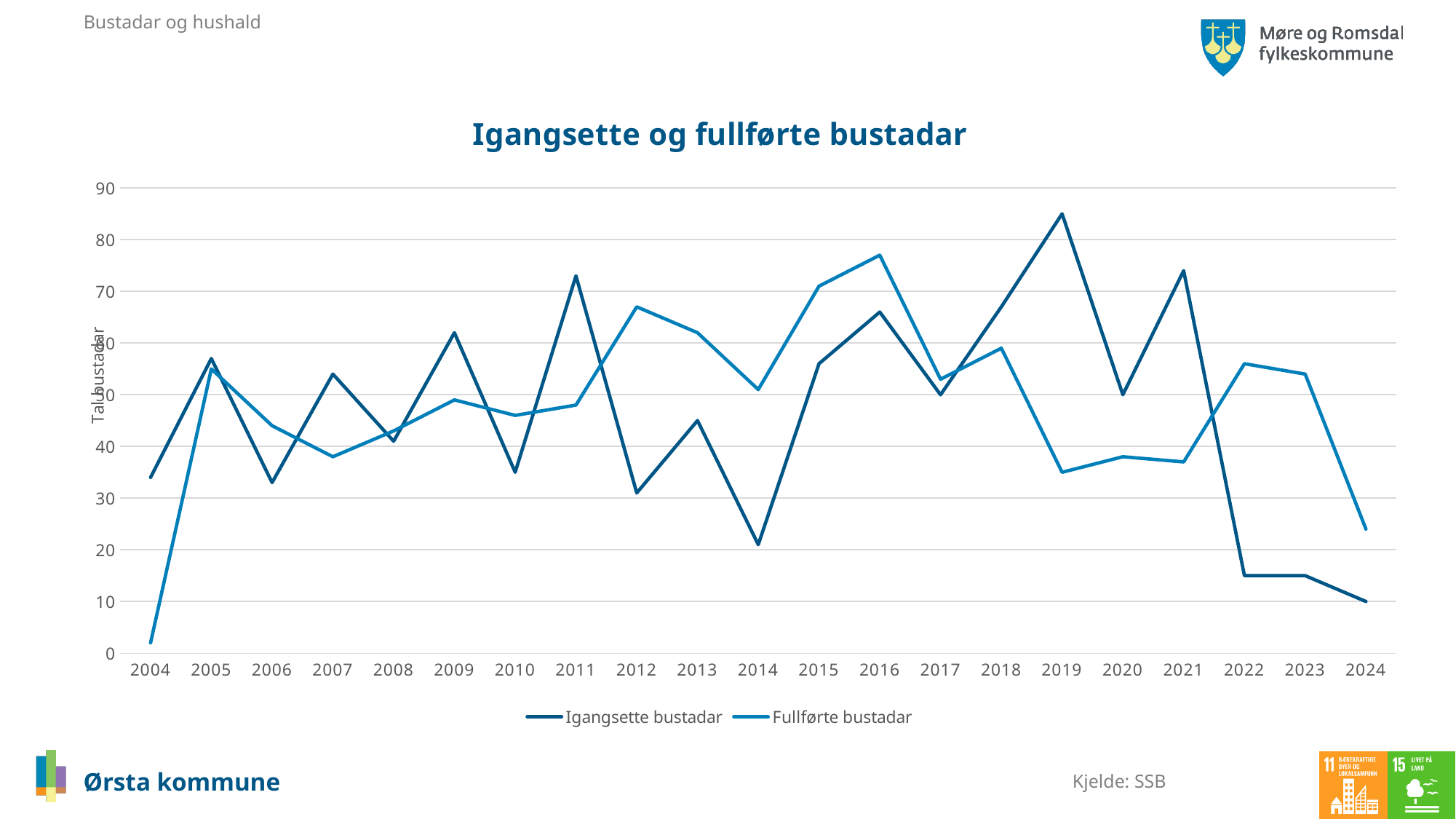
What is the title of the chart? Igangsette og fullførte bustadar Is the value for Igangsette bustadar in 2019 greater or less than 80? greater Is the value for Igangsette bustadar in 2022 greater or less than 20? less How many series does the legend list? 2 What kind of chart is shown on the slide? line chart In which year is the value for Fullførte bustadar highest? 2016 In which year is the value for Igangsette bustadar highest? 2019 Is the value for Fullførte bustadar in 2004 greater or less than 10? less In 2016, which series has the larger value, Igangsette bustadar or Fullførte bustadar? Fullførte bustadar In which year is the value for Fullførte bustadar lowest? 2004 In which year is the value for Igangsette bustadar lowest? 2024 How many years are shown on the x axis? 21